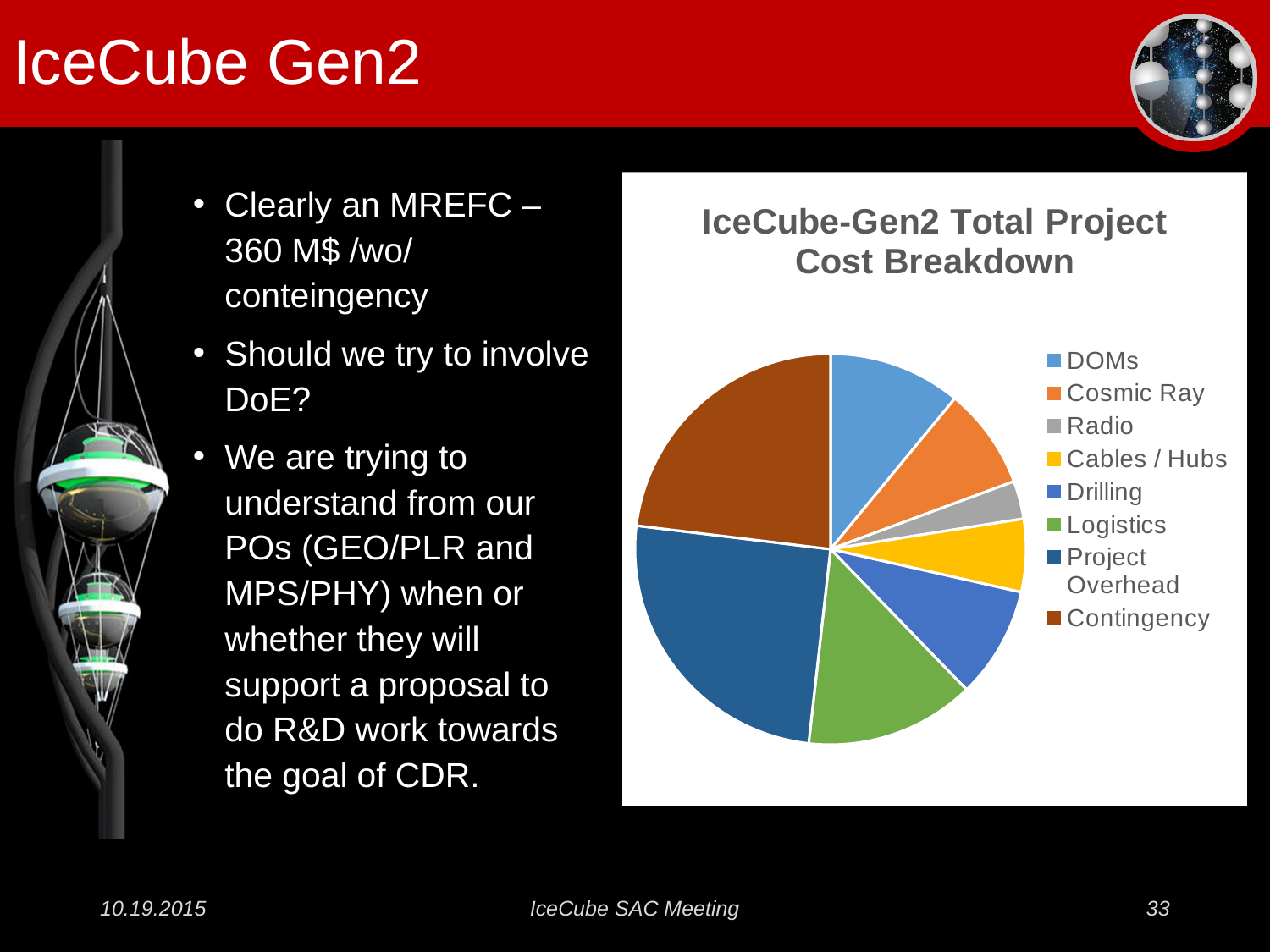
What kind of chart is shown on the slide? pie chart Which slice is larger, Logistics or Cables / Hubs? Logistics Which slice is larger, DOMs or Radio? DOMs How many entries does the legend list? 8 What is the title of the chart? IceCube-Gen2 Total Project Cost Breakdown Which slice is larger, Cosmic Ray or Radio? Cosmic Ray How many slices does the pie chart have? 8 Which category has the largest slice of the pie? Project Overhead Which category is shown in brown in the pie chart? Contingency Which category has the smallest slice of the pie? Radio